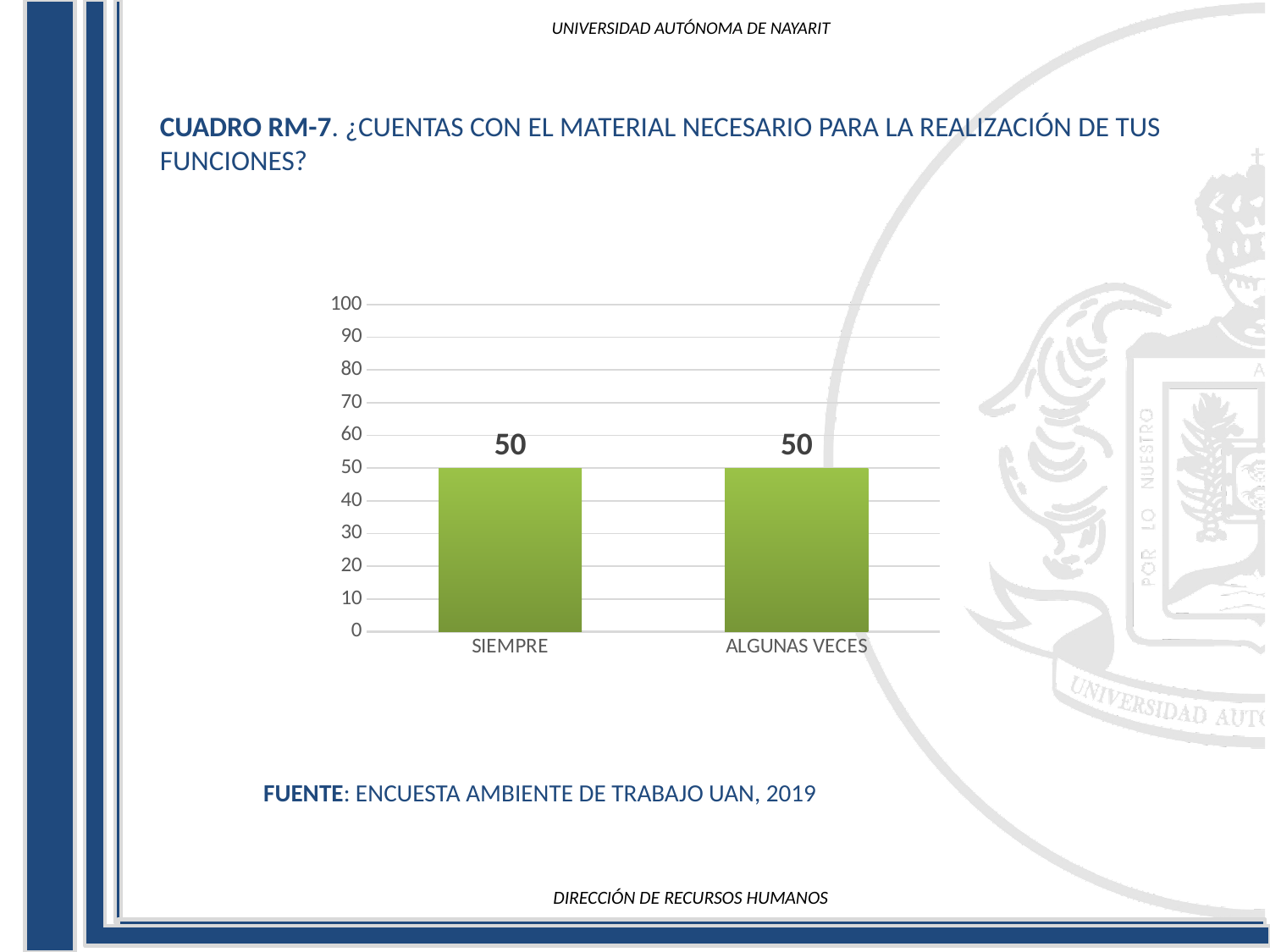
Is the value for ALGUNAS VECES greater or less than 20? greater What is the value for SIEMPRE? 50 Is the value for SIEMPRE greater or less than 80? less What kind of chart is shown on the slide? Bar chart How many categories are shown on the x axis? 2 Are the values for SIEMPRE and ALGUNAS VECES equal? Yes What is the value for ALGUNAS VECES? 50 What is the total of the two values shown in the chart? 100 What is the difference between the values for SIEMPRE and ALGUNAS VECES? 0 What is the maximum value shown on the vertical axis? 100 What source is cited below the chart? ENCUESTA AMBIENTE DE TRABAJO UAN, 2019